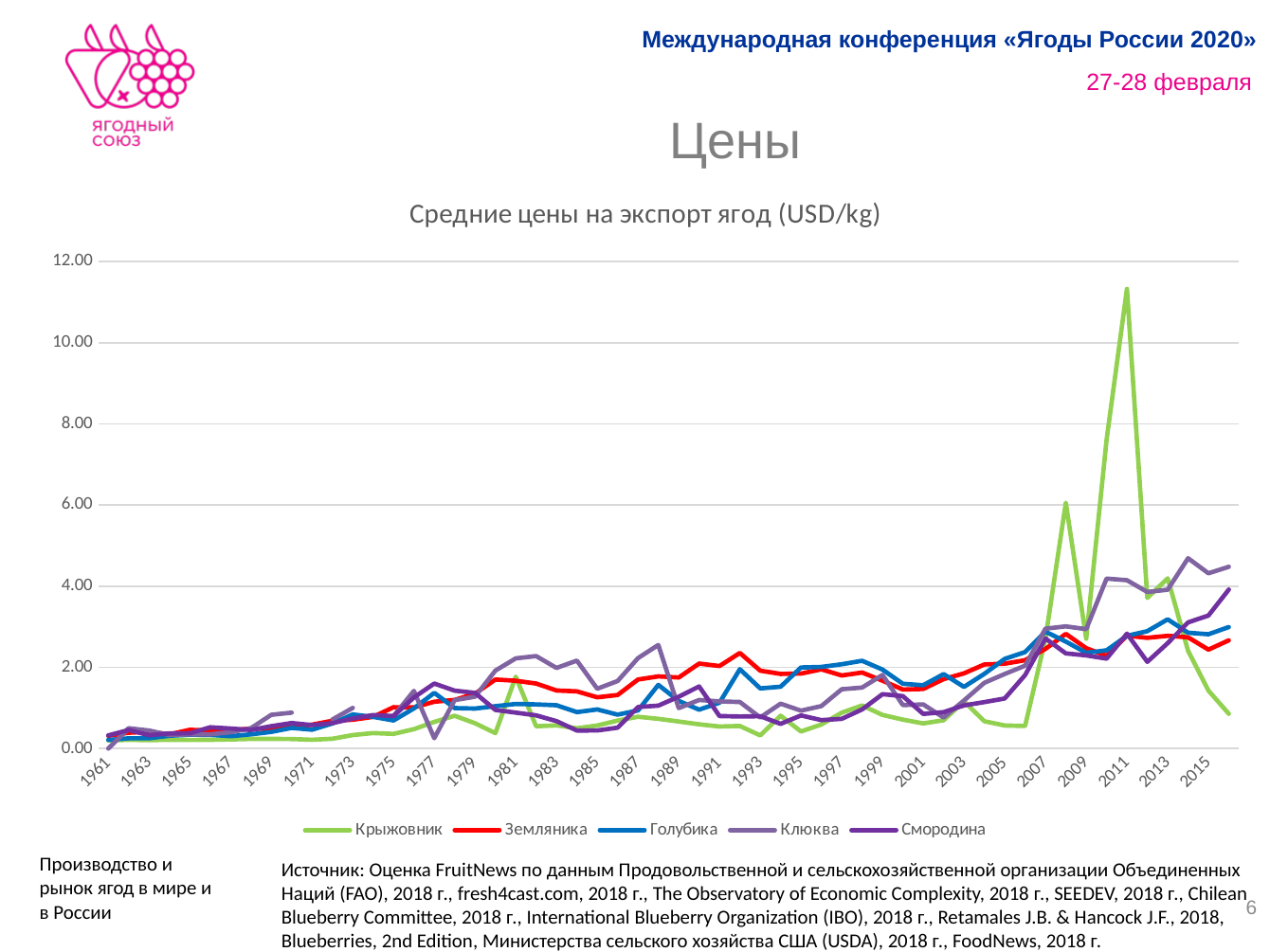
Is the value for Земляника in 2015 greater or less than 4.00? less Is the peak value for Крыжовник around 2011 greater or less than 10.00? greater What is the title of the chart? Средние цены на экспорт ягод (USD/kg) How many series does the legend list? 5 What kind of chart is shown on the slide? line chart Which series reaches the highest value anywhere on the chart? Крыжовник Is the value for Клюква in 2015 greater or less than 4.00? greater What is the first year shown on the x axis? 1961 Which series is drawn with the green line? Крыжовник Does the value for Земляника generally rise or fall from 1961 to 2015? rise Around 2011, which is larger: the value for Крыжовник or the value for Земляника? Крыжовник